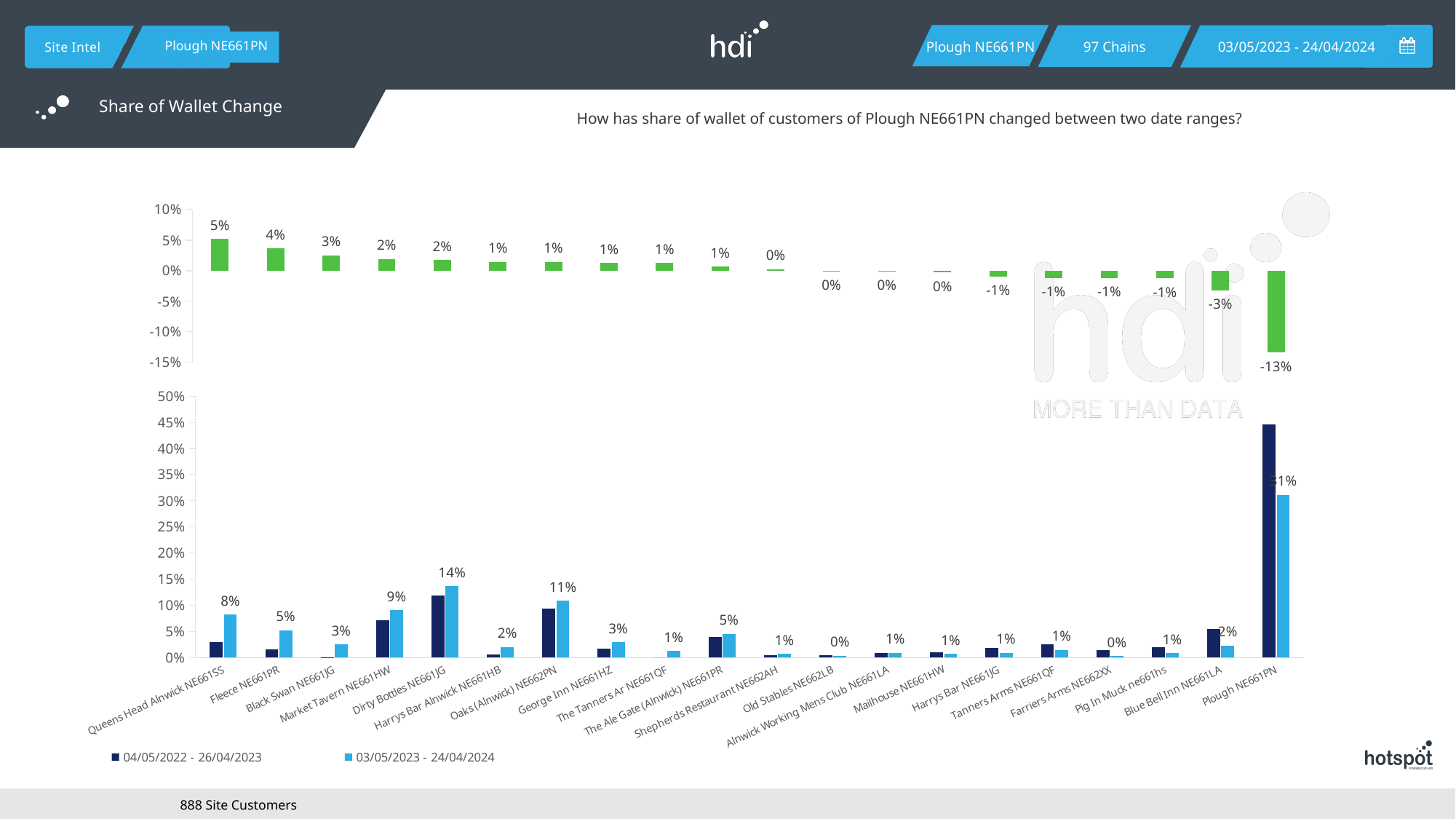
In the bottom chart, what is the value for Dirty Bottles NE661JG in the 03/05/2023 - 24/04/2024 series? 14% In the top chart (share of wallet change), what is the value for Queens Head Alnwick NE661SS? 5% How many categories are shown on the x axis of the bottom chart? 20 In the bottom chart, which is larger in the 03/05/2023 - 24/04/2024 series: Oaks (Alnwick) NE662PN or Market Tavern NE661HW? Oaks (Alnwick) NE662PN In the top chart (share of wallet change), what is the difference between the values for Fleece NE661PR and Blue Bell Inn NE661LA? 7% In the bottom chart, is the value for Plough NE661PN in the 04/05/2022 - 26/04/2023 series greater or less than 40%? greater In the top chart (share of wallet change), which category has the highest value? Queens Head Alnwick NE661SS What kind of chart is the bottom chart? Bar chart In the top chart (share of wallet change), what is the value for Plough NE661PN? -13% How many series does the legend of the bottom chart list? 2 In the bottom chart, what is the value for Plough NE661PN in the 03/05/2023 - 24/04/2024 series? 31% In the top chart (share of wallet change), which category has the lowest value? Plough NE661PN